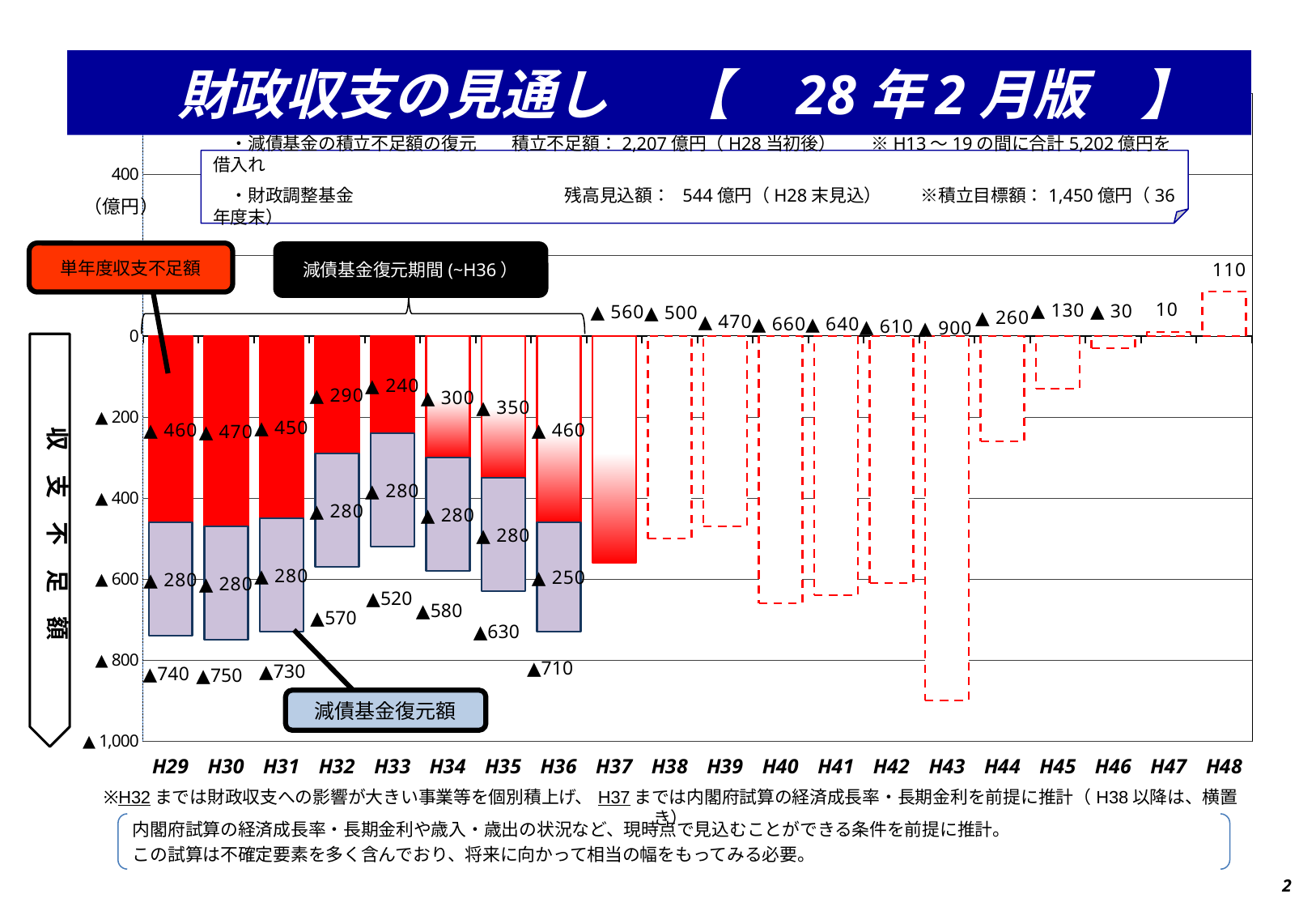
According to the callout label, what do the red bars represent? 単年度収支不足額 Among H29 to H36, which fiscal year has the smallest total deficit labelled below the bar? H33 What is the difference between the total deficit labelled for H29 (▲740) and for H33 (▲520)? 220 Which has the larger 単年度収支不足額, H37 or H38? H37 What is the 減債基金復元額 value labelled for H36? ▲250 What value is labelled for H48 in the chart? 110 What is the 単年度収支不足額 value labelled for H45? ▲130 What is the 単年度収支不足額 (single-year deficit) value labelled for H43? ▲900 What kind of chart is shown on the slide? bar chart How many fiscal years (categories) are shown along the x axis of the chart? 20 Which fiscal year has the largest 単年度収支不足額 (single-year deficit) in the chart? H43 What is the total deficit value labelled below the bar for H30? ▲750